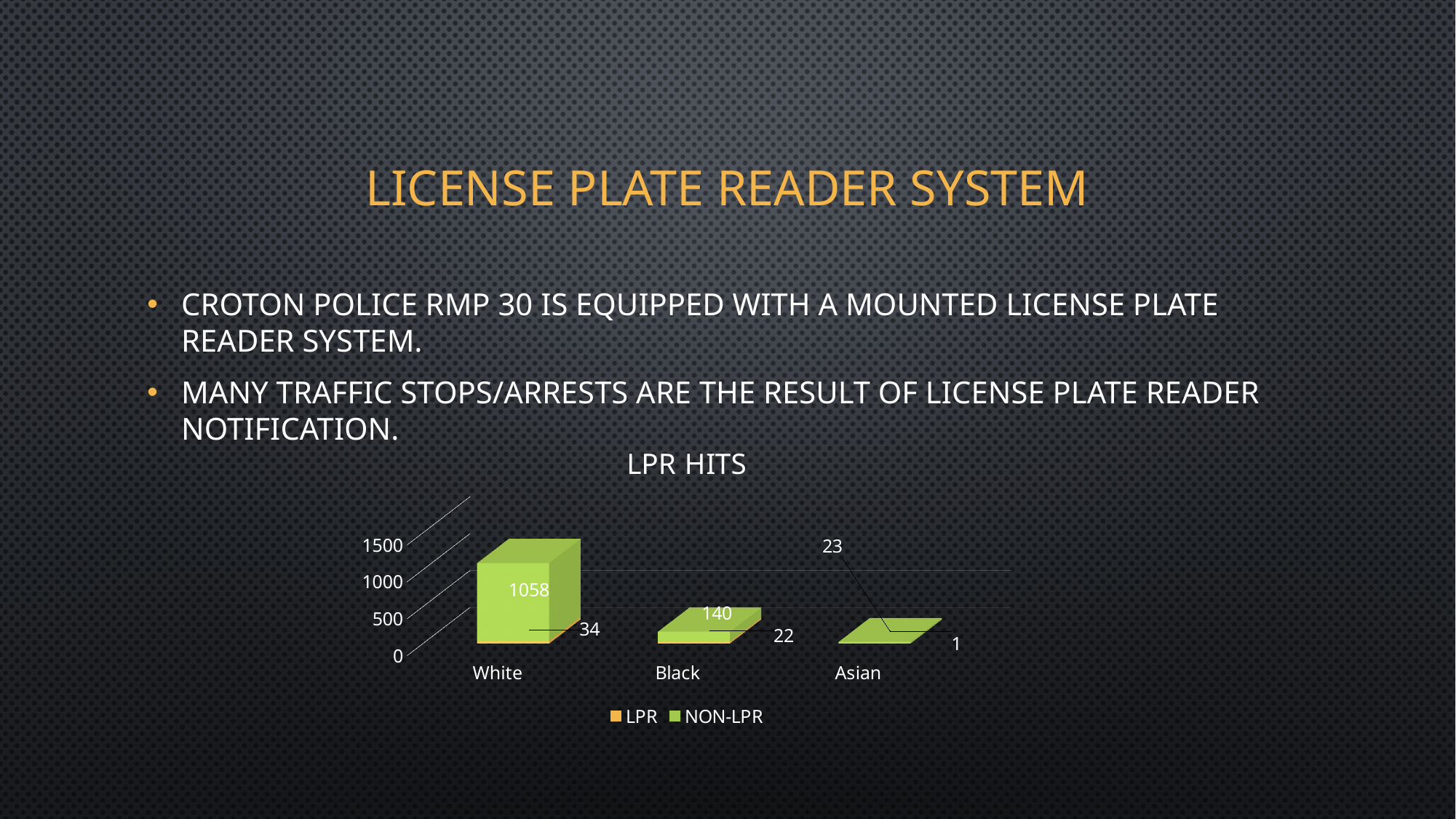
What type of chart is shown on the slide? Bar chart What is the LPR value for Black? 22 How many categories are shown on the x axis? 3 What is the LPR value for White? 34 Which has the larger LPR value, White or Black? White What is the difference between the NON-LPR values for White and Black? 918 What is the NON-LPR value for Black? 140 Is the NON-LPR value for White greater or less than 1000? greater What is the title of the chart? LPR HITS Which category has the highest NON-LPR value? White What is the NON-LPR value for White? 1058 How many series does the legend list? 2